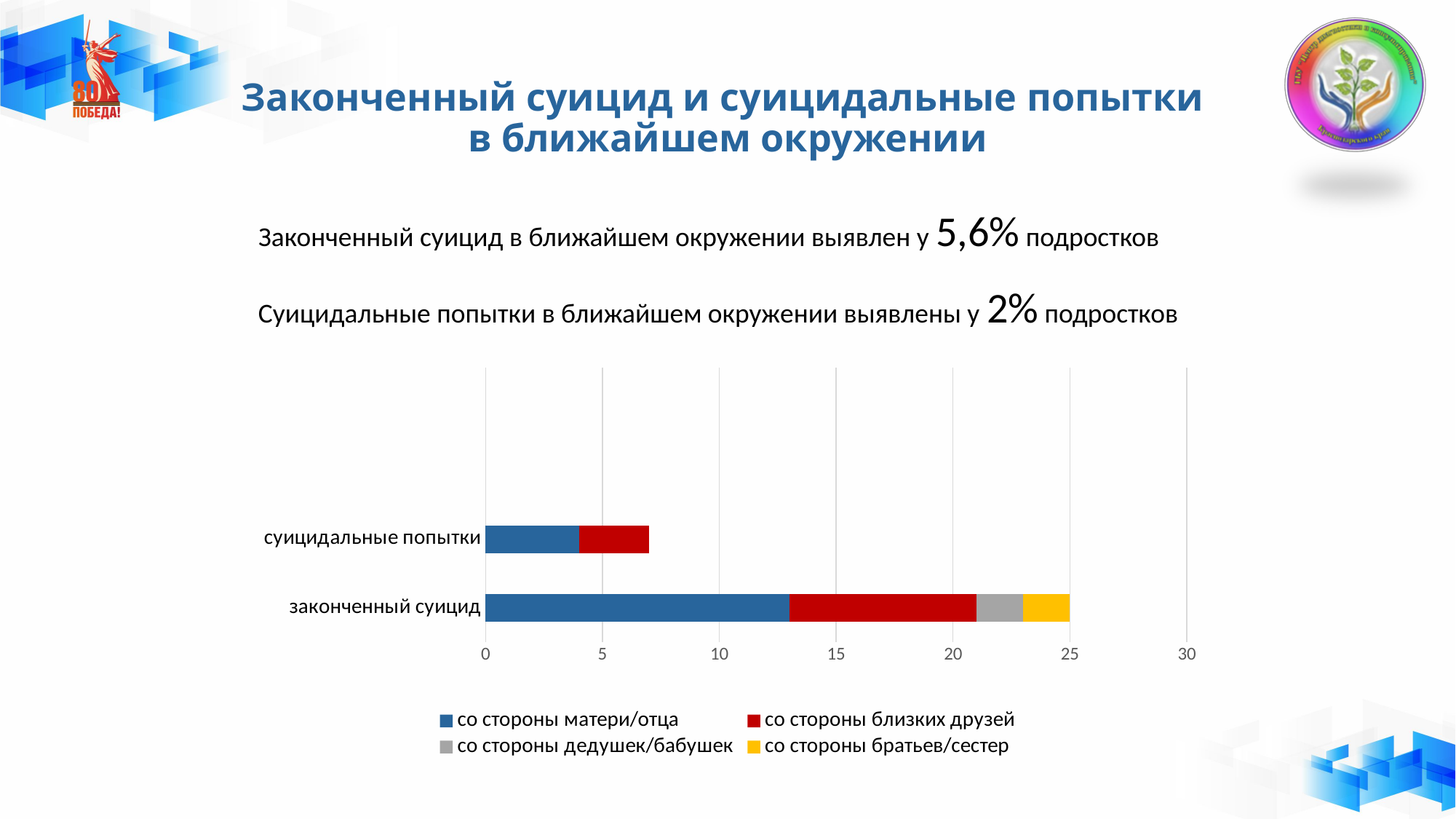
Which category has the longer total bar, "суицидальные попытки" or "законченный суицид"? законченный суицид How many series segments appear in the bar for "суицидальные попытки"? 2 How many series does the chart legend list? 4 What colour represents the series "со стороны братьев/сестер" in the chart? yellow Which category has the highest total value in the chart? законченный суицид Which category has the lowest total value in the chart? суицидальные попытки What kind of chart is shown on the slide? bar chart How many categories are plotted on the y axis of the chart? 2 Is the value of the "со стороны матери/отца" segment for "законченный суицид" greater or less than 10? greater Is the total value of the bar for "суицидальные попытки" greater or less than 10? less What is the total value of the stacked bar for "законченный суицид"? 25 Is the total value of the bar for "суицидальные попытки" greater or less than 5? greater